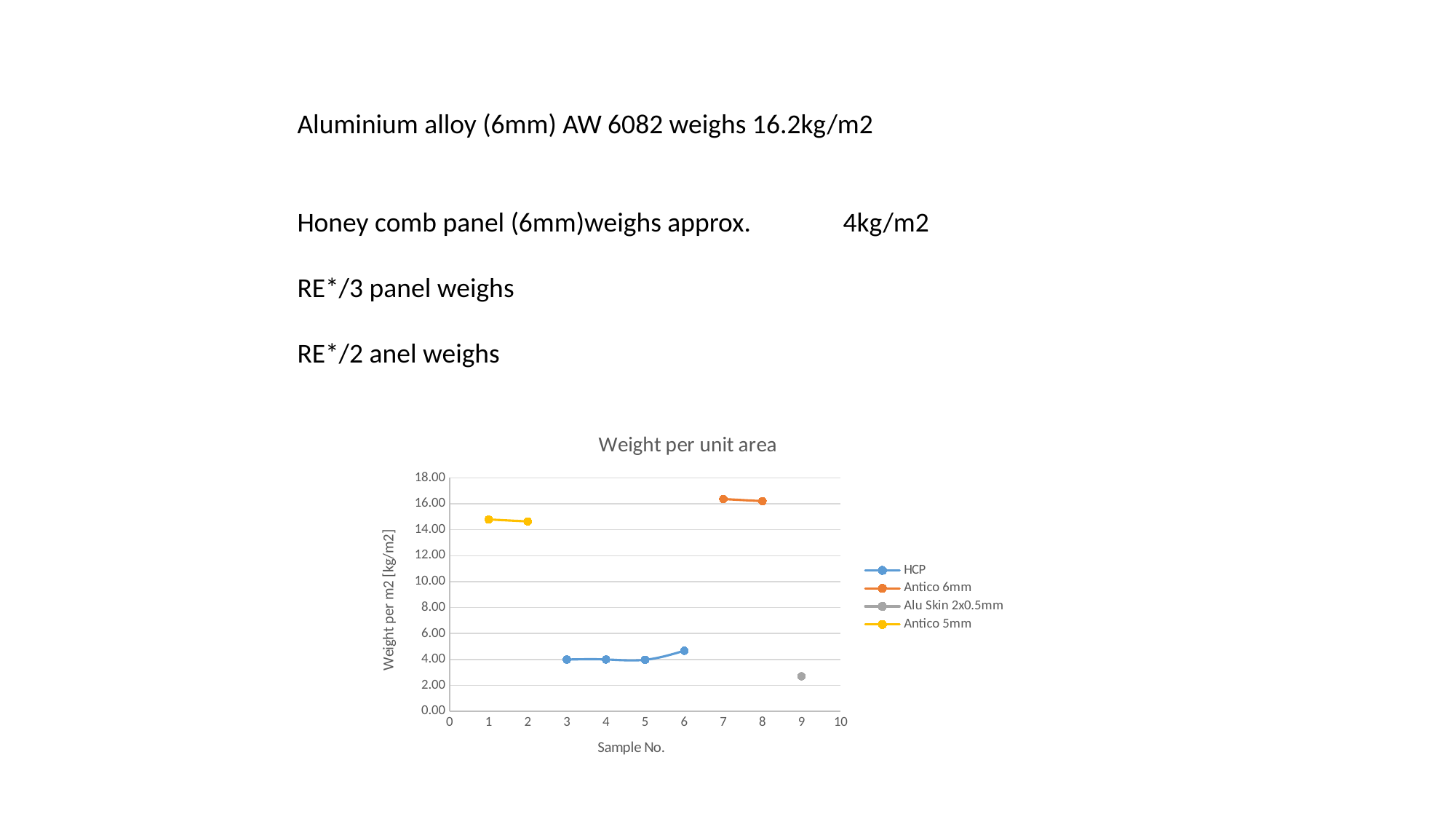
Is the value for Antico 5mm at sample 1 greater or less than 14.00? greater What is the label of the y axis? Weight per m2 [kg/m2] How many series does the legend list? 4 Which is larger, the value for HCP at sample 6 or the value for Alu Skin 2x0.5mm at sample 9? HCP at sample 6 What kind of chart is shown on the slide? line chart Which series has the highest values on the chart? Antico 6mm Is the value for Antico 6mm at sample 7 greater or less than 16.00? greater Is the value for Alu Skin 2x0.5mm at sample 9 greater or less than 4.00? less How many data points are plotted for the HCP series? 4 What is the title of the chart? Weight per unit area Which series has the lowest value on the chart? Alu Skin 2x0.5mm Does the HCP series rise or fall between sample 5 and sample 6? rise